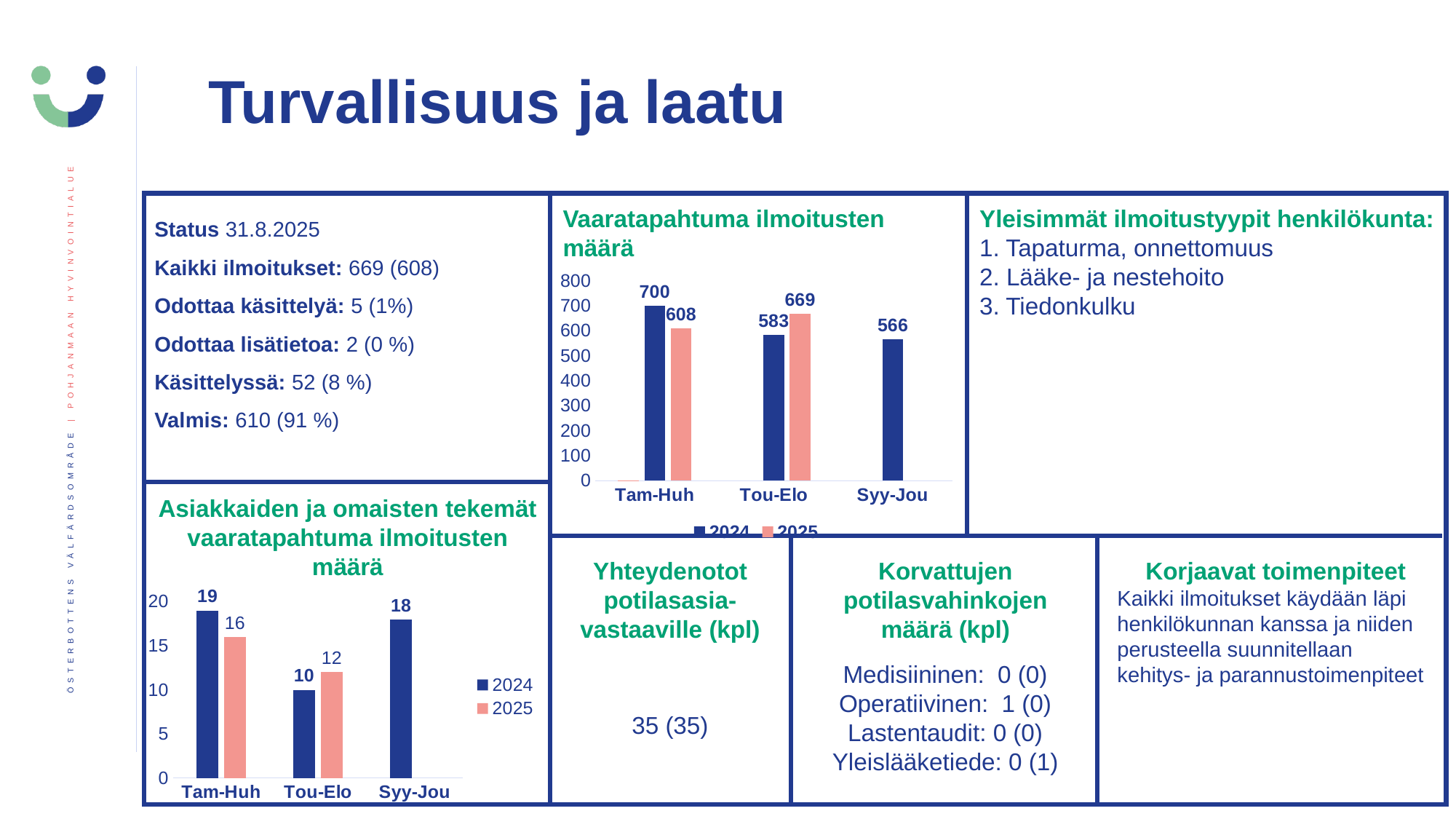
In the 'Asiakkaiden ja omaisten tekemät vaaratapahtuma ilmoitusten määrä' chart, which period has the lowest 2024 value? Tou-Elo In the 'Vaaratapahtuma ilmoitusten määrä' chart, what is the 2024 value for Syy-Jou? 566 In the 'Vaaratapahtuma ilmoitusten määrä' chart, which period has the highest 2024 value? Tam-Huh In the 'Vaaratapahtuma ilmoitusten määrä' chart, what is the 2025 value for Tou-Elo? 669 In the 'Asiakkaiden ja omaisten tekemät vaaratapahtuma ilmoitusten määrä' chart, what is the difference between the 2024 and 2025 values for Tam-Huh? 3 In the 'Asiakkaiden ja omaisten tekemät vaaratapahtuma ilmoitusten määrä' chart, what is the 2024 value for Tam-Huh? 19 In the 'Vaaratapahtuma ilmoitusten määrä' chart, is the 2024 value for Tou-Elo greater or less than the 2025 value for Tou-Elo? less In the 'Vaaratapahtuma ilmoitusten määrä' chart, what is the difference between the 2024 and 2025 values for Tam-Huh? 92 In the 'Vaaratapahtuma ilmoitusten määrä' chart, what is the 2024 value for Tam-Huh? 700 In the 'Asiakkaiden ja omaisten tekemät vaaratapahtuma ilmoitusten määrä' chart, what is the 2025 value for Tou-Elo? 12 What kind of chart is the 'Asiakkaiden ja omaisten tekemät vaaratapahtuma ilmoitusten määrä' chart? Bar chart How many series does the legend of the 'Vaaratapahtuma ilmoitusten määrä' chart list? 2